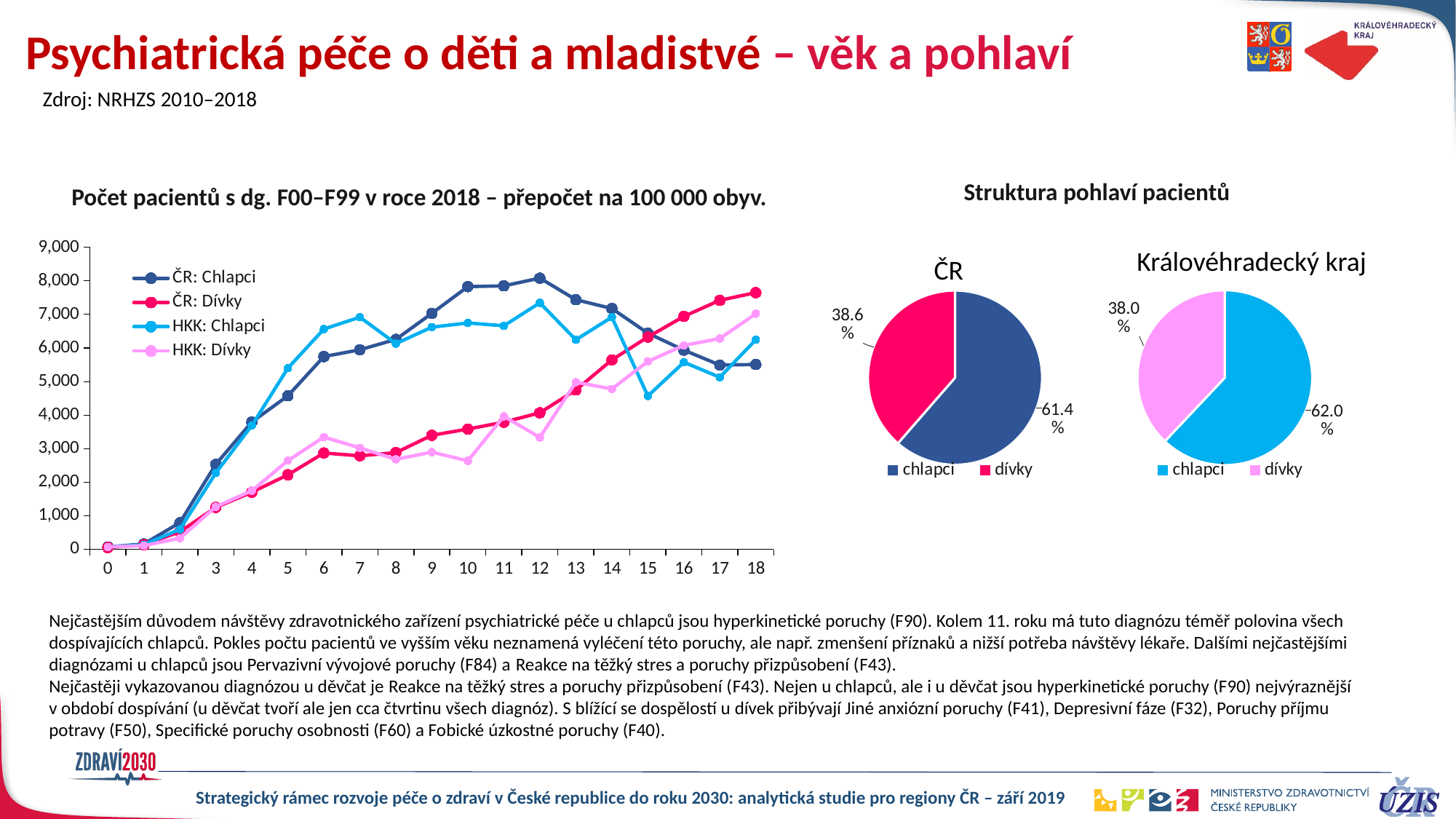
In the line chart "Počet pacientů s dg. F00–F99 v roce 2018", does the ČR: Dívky series generally rise or fall from age 0 to age 18? rise Which pie chart shows the larger share for chlapci: "ČR" or "Královéhradecký kraj"? Královéhradecký kraj In the line chart "Počet pacientů s dg. F00–F99 v roce 2018", which is larger at age 12: ČR: Chlapci or ČR: Dívky? ČR: Chlapci In the line chart "Počet pacientů s dg. F00–F99 v roce 2018", how many age points are shown on the x axis? 19 In the line chart "Počet pacientů s dg. F00–F99 v roce 2018", is the value for ČR: Dívky at age 5 greater or less than 3,000? less In the pie chart titled "ČR", what share of patients are chlapci? 61.4% In the pie chart titled "Královéhradecký kraj", what share of patients are dívky? 38.0% In the line chart "Počet pacientů s dg. F00–F99 v roce 2018", is the value for ČR: Chlapci at age 12 greater or less than 7,000? greater In the line chart "Počet pacientů s dg. F00–F99 v roce 2018", how many series does the legend list? 4 What kind of chart is the chart titled "Počet pacientů s dg. F00–F99 v roce 2018 – přepočet na 100 000 obyv."? line chart In the line chart "Počet pacientů s dg. F00–F99 v roce 2018", which is larger at age 18: ČR: Chlapci or ČR: Dívky? ČR: Dívky In the line chart "Počet pacientů s dg. F00–F99 v roce 2018", is the value for HKK: Chlapci at age 15 greater or less than 5,000? less